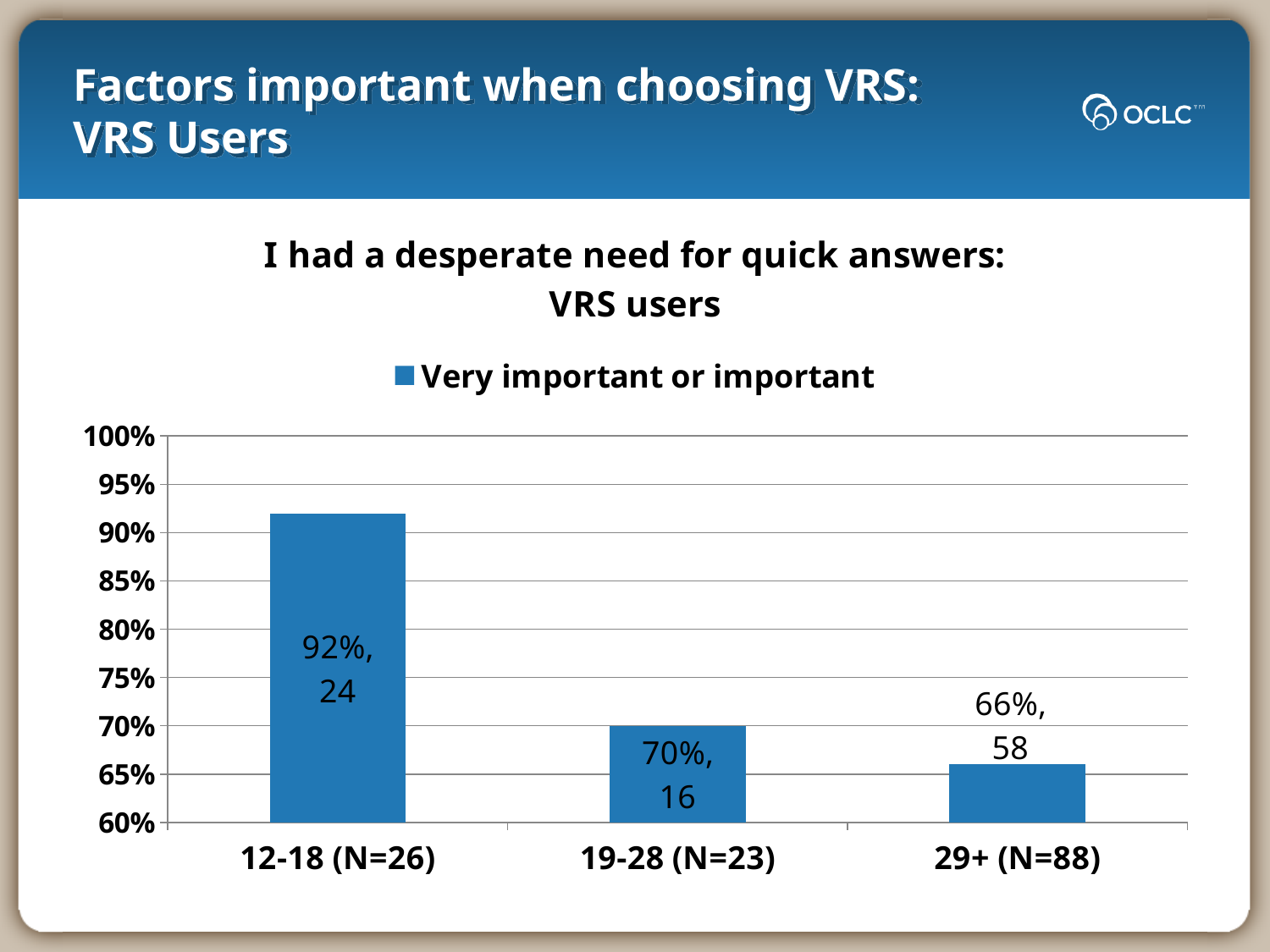
Which age group has the lowest percentage? 29+ (N=88) What percentage is shown for the 29+ (N=88) age group? 66% How many age groups are shown on the chart? 3 What type of chart is shown? Bar chart Do the percentages rise or fall from the youngest to the oldest age group? Fall Which group has a higher percentage, 19-28 (N=23) or 29+ (N=88)? 19-28 (N=23) What is the difference in percentage points between the 12-18 (N=26) group and the 29+ (N=88) group? 26 How many series does the legend list? 1 Which age group has the highest percentage? 12-18 (N=26) What percentage of the 12-18 (N=26) age group rated 'I had a desperate need for quick answers' as very important or important? 92% How many respondents in the 29+ (N=88) group rated this factor as very important or important? 58 What percentage is shown for the 19-28 (N=23) age group? 70%